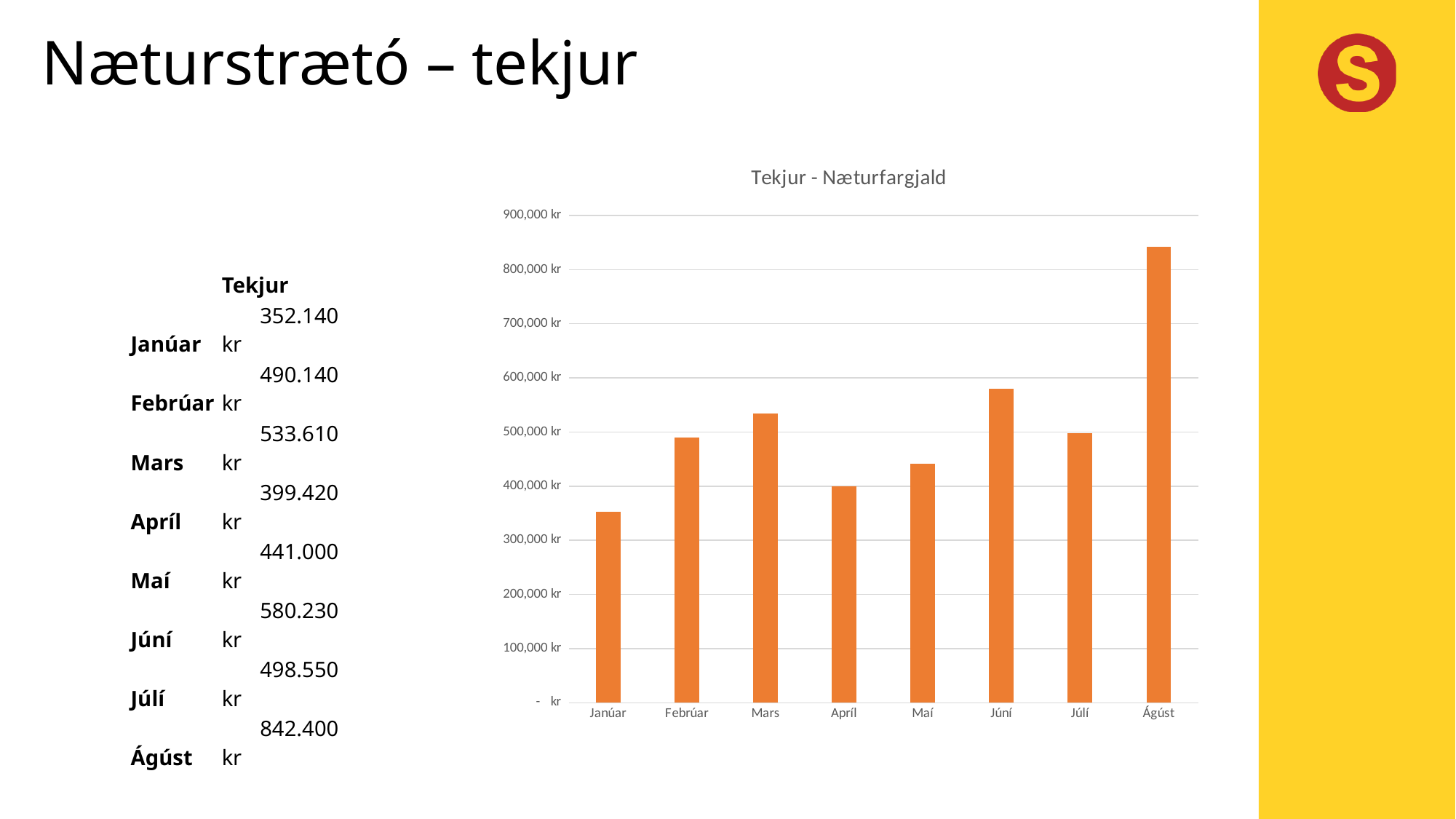
Which month has the highest value in the chart? Ágúst What is the value for Mars? 533.610 kr Is the value for Apríl greater or less than 500,000 kr? less What is the value for Júní? 580.230 kr Is the value for Júní greater or less than 500,000 kr? greater What is the title of the chart? Tekjur - Næturfargjald What is the difference between the value for Ágúst and the value for Janúar? 490.260 kr Which month has the lowest value in the chart? Janúar What is the value for Ágúst? 842.400 kr Which is larger, the value for Febrúar or the value for Maí? Febrúar How many months are shown on the x axis of the chart? 8 What kind of chart is shown on the slide? bar chart